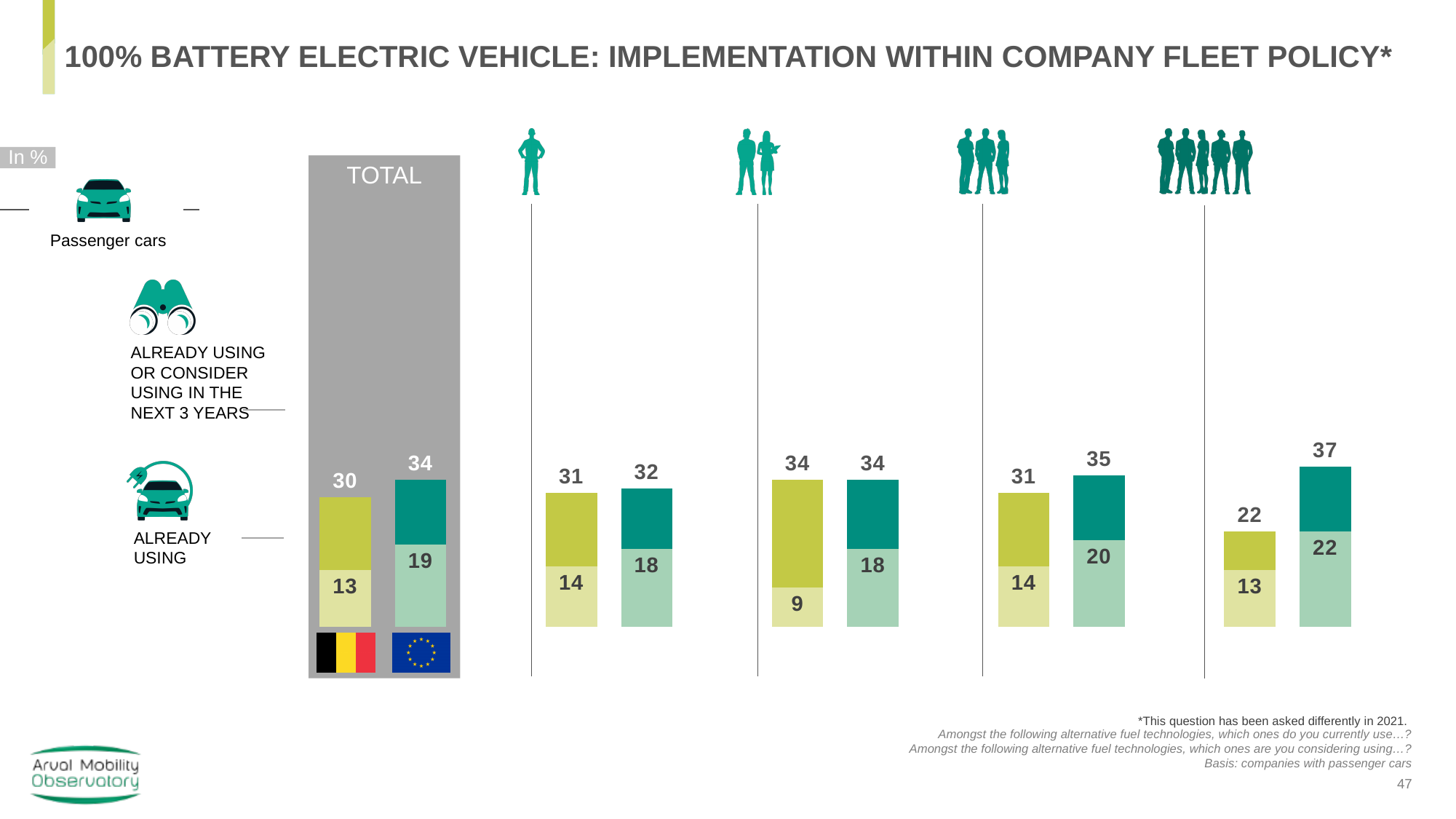
In the rightmost group of bars, what is the difference between the European and Belgian values for 'already using or consider using in the next 3 years'? 15 How many groups of bars are shown on the chart, including TOTAL? 5 In the rightmost group of bars, what is the European value for 'already using'? 22 What kind of chart is shown on the slide? Bar chart In the TOTAL column, which has the larger 'already using' value, the Belgian bar or the European bar? European bar Which two flags are used to identify the bars in the TOTAL column? Belgium and the European Union In the rightmost group of bars (largest company icon), what is the Belgian value for 'already using or consider using in the next 3 years'? 22 In the TOTAL column, what is the difference between the European and Belgian values for 'already using or consider using in the next 3 years'? 4 What is the lowest 'already using' value shown on the chart? 9 In the TOTAL column, what percentage of European companies (EU flag bar) are already using 100% battery electric vehicles? 19 In the TOTAL column, what percentage of Belgian companies (Belgian flag bar) are already using or consider using 100% battery electric vehicles in the next 3 years? 30 What is the highest 'already using or consider using in the next 3 years' value shown on the chart? 37